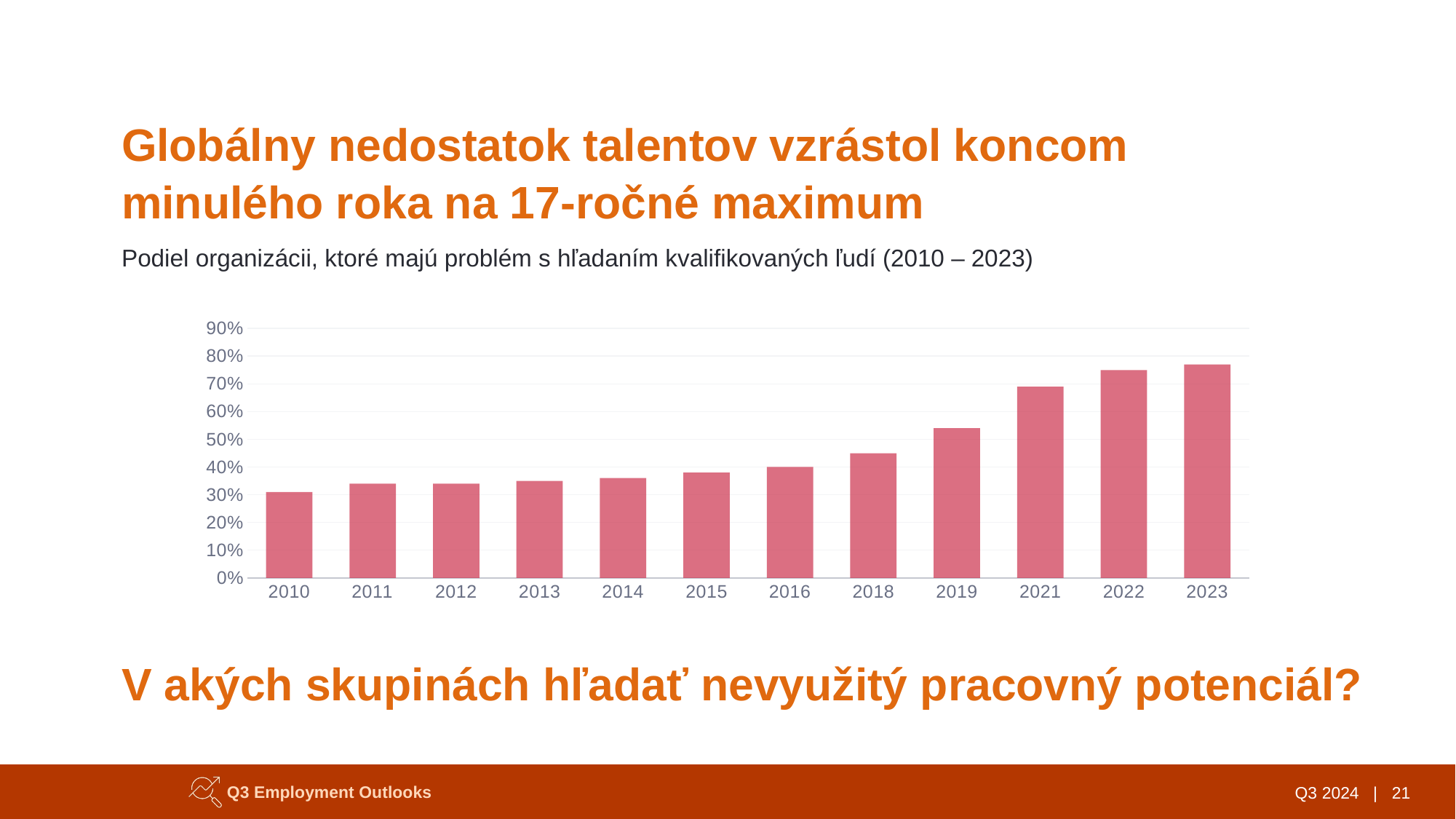
Is the value for 2019 greater or less than 50%? greater Is the value for 2010 greater or less than 40%? less What period does the chart subtitle say the data covers? 2010 – 2023 Which year has the larger value, 2019 or 2021? 2021 Which year has the highest bar in the chart? 2023 Is the value for 2023 greater or less than 70%? greater Do the values generally rise or fall from 2010 to 2023? rise How many years are shown on the x axis of the chart? 12 What kind of chart is shown on the slide? bar chart Which year has the lowest bar in the chart? 2010